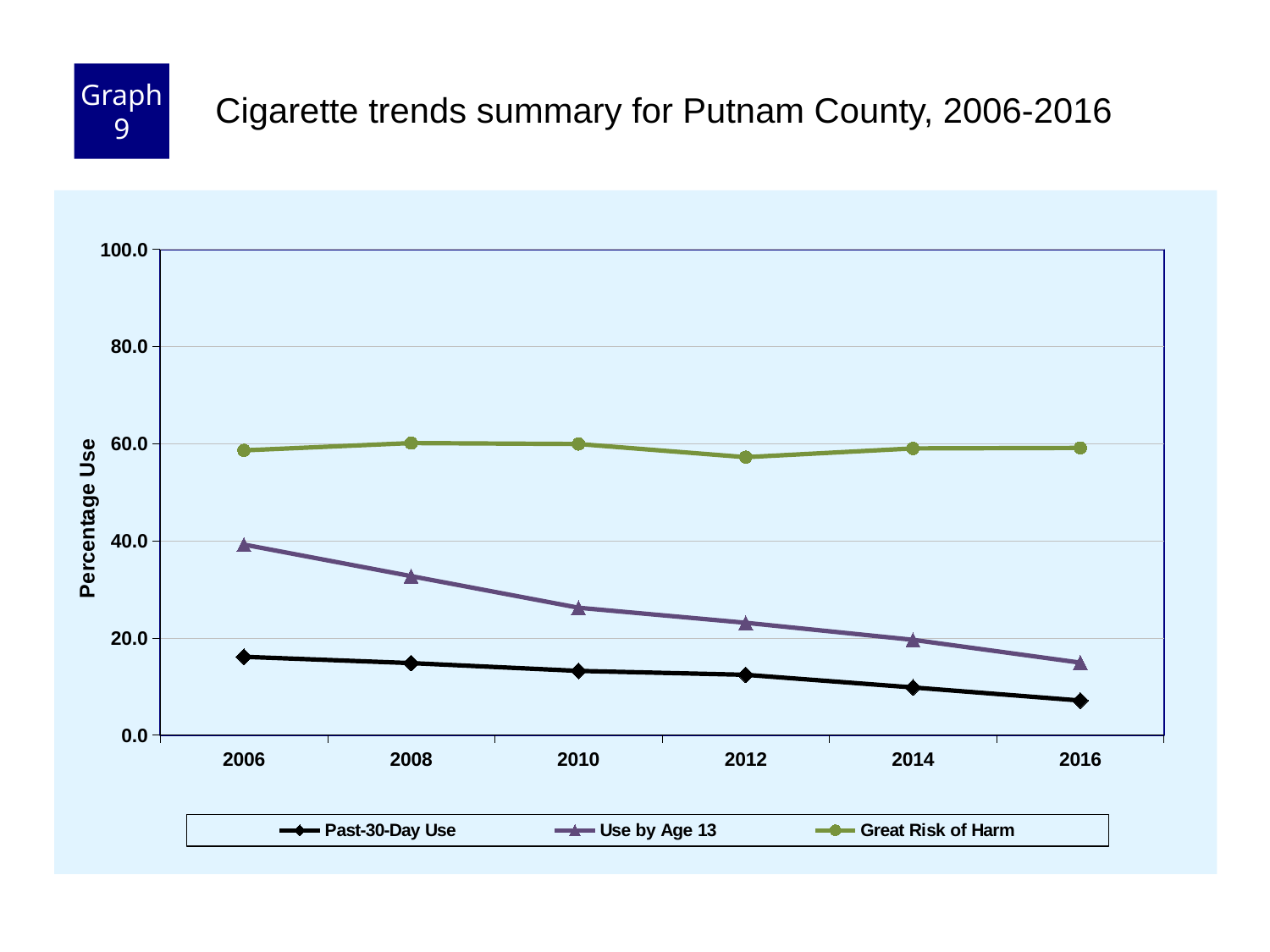
What is the label of the y axis? Percentage Use How many years are plotted along the x axis? 6 How many series does the legend list? 3 Is the value for Use by Age 13 in 2008 greater or less than 40.0? less Is the value for Past-30-Day Use in 2006 greater or less than 20.0? less Which series has the highest values across all years? Great Risk of Harm In which year is Past-30-Day Use at its lowest? 2016 Is the value for Great Risk of Harm in 2012 greater or less than 60.0? less In which year is Use by Age 13 at its highest? 2006 What kind of chart is shown on the slide? line chart Does Use by Age 13 rise or fall from 2006 to 2016? fall Which series has the lowest values across all years? Past-30-Day Use